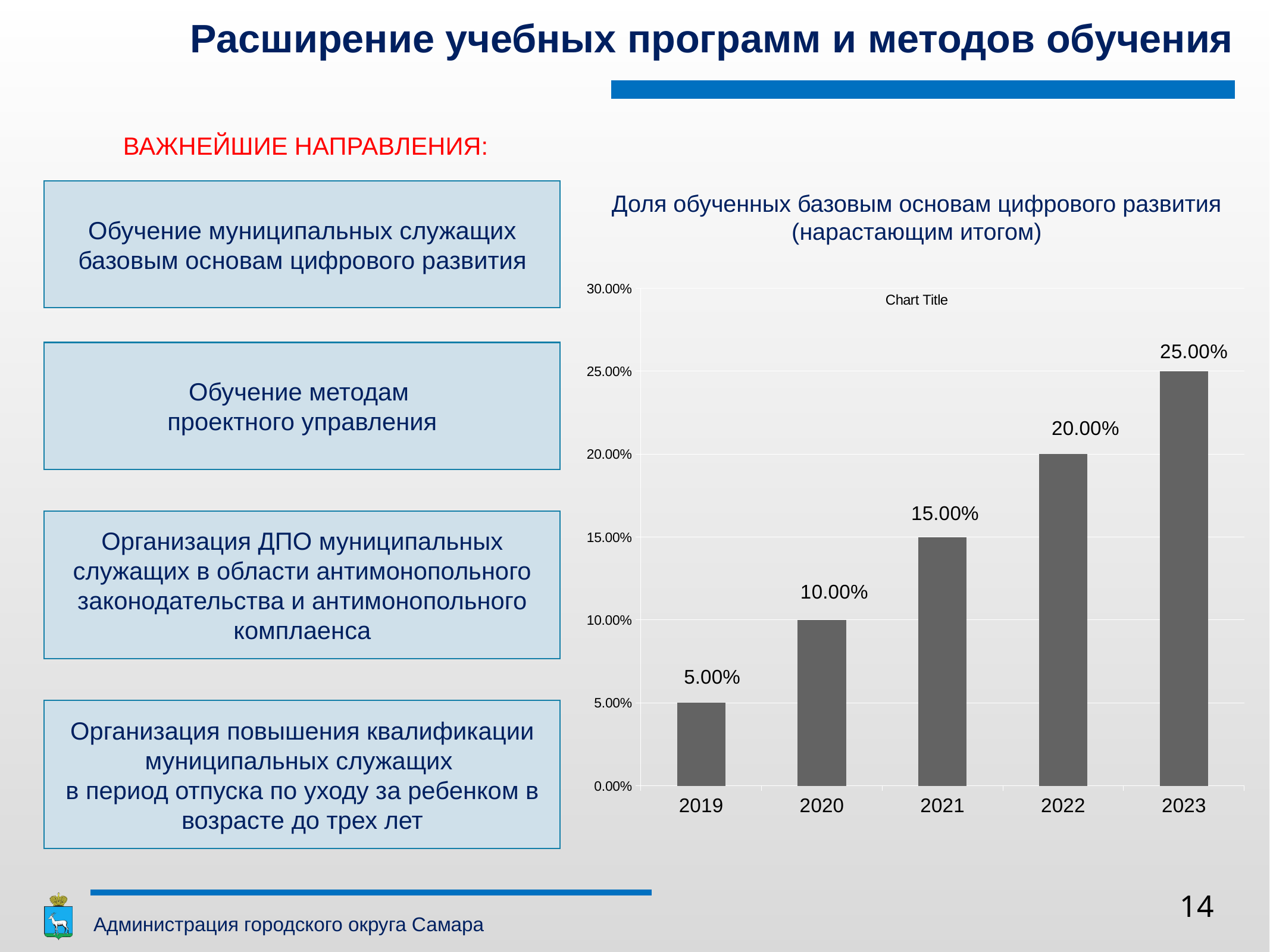
What is the value for 2023? 25.00% Which is larger, the value for 2020 or the value for 2022? 2022 What is the title shown above the chart? Доля обученных базовым основам цифрового развития (нарастающим итогом) What kind of chart is shown? bar chart What is the value for 2019? 5.00% Which year has the lowest value? 2019 What is the value for 2021? 15.00% Which year has the highest value? 2023 What is the difference between the values for 2022 and 2021? 5.00% Do the values rise or fall from 2019 to 2023? rise What is the difference between the values for 2023 and 2020? 15.00% How many years are shown on the x axis? 5